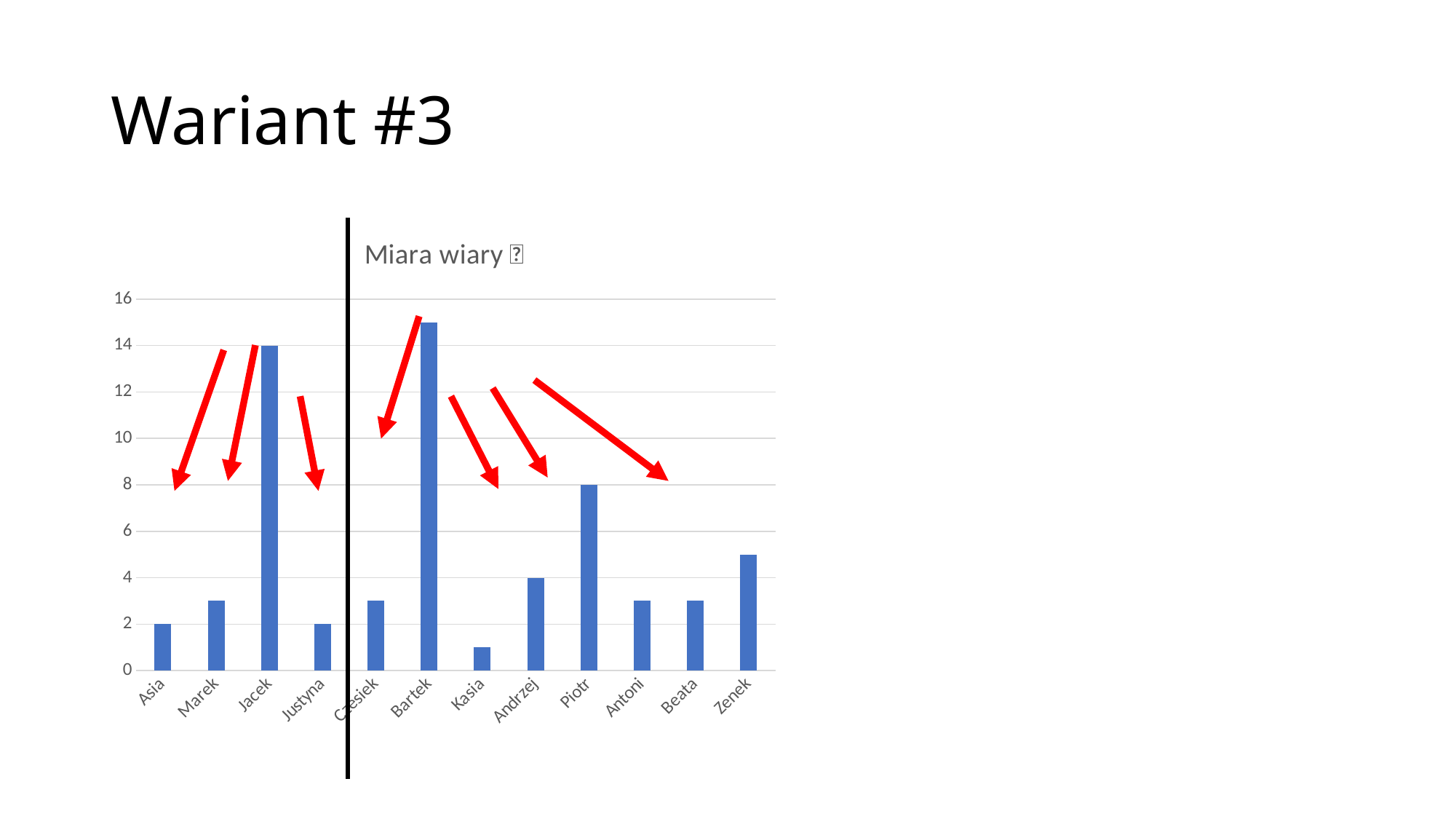
What is the value for Jacek? 14 Is the value for Kasia greater or less than 2? less What is the difference between the values for Jacek and Asia? 12 What is the title of the chart? Miara wiary What kind of chart is shown on the slide? bar chart How many categories (names) are shown on the x axis of the chart? 12 What is the value for Piotr? 8 Which category has the lowest bar in the chart? Kasia Which category has the highest bar in the chart? Bartek Which is larger, the value for Piotr or the value for Andrzej? Piotr Is the value for Bartek greater or less than 14? greater What is the value for Andrzej? 4